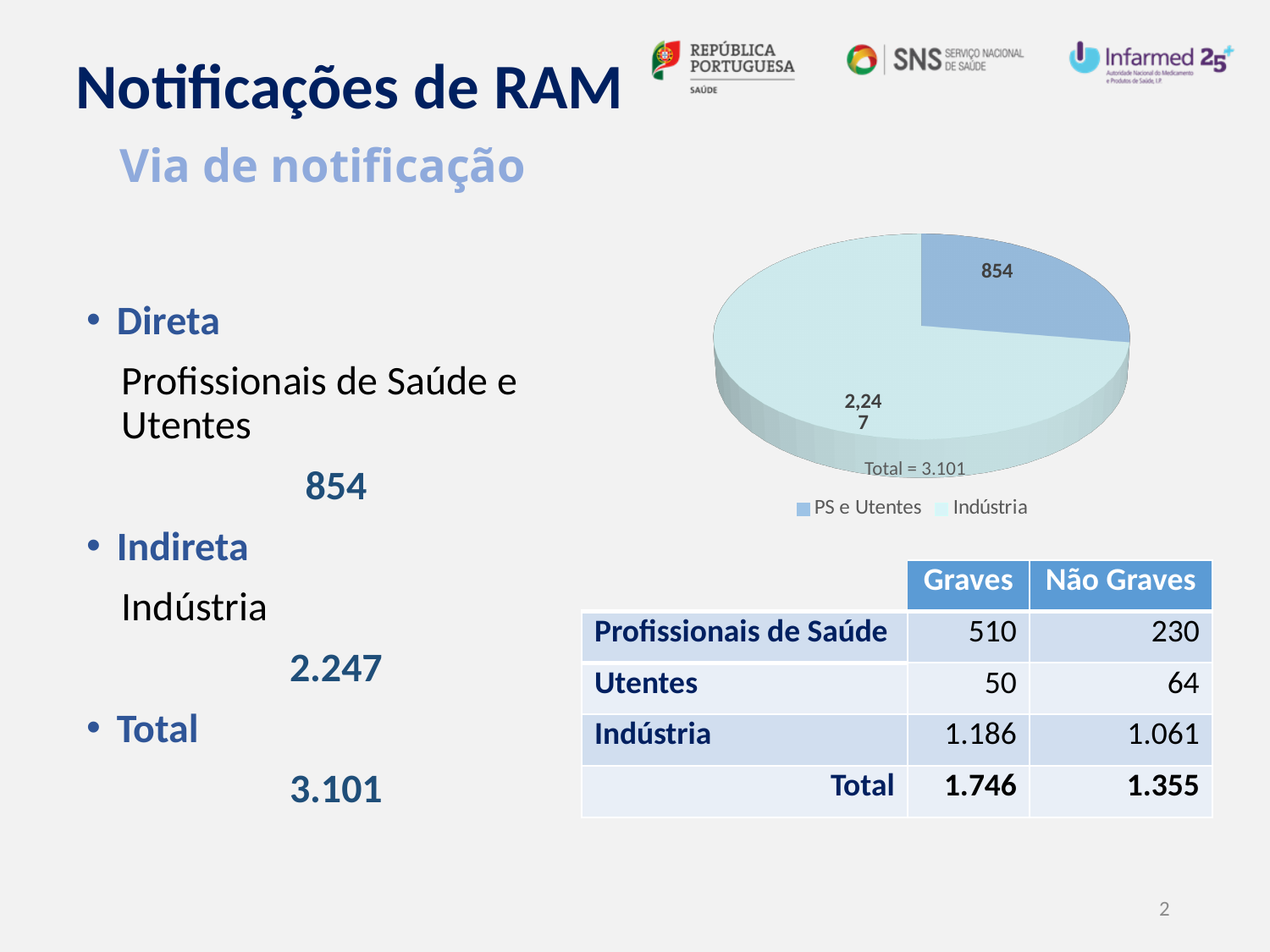
What total is printed on the pie chart? Total = 3.101 What is the difference between the Indústria and PS e Utentes values in the pie chart? 1,393 What is the value of the PS e Utentes slice in the pie chart? 854 Which slice of the pie chart is drawn in the darker blue colour? PS e Utentes What is the value of the Indústria slice in the pie chart? 2,247 Which slice of the pie chart is the smallest? PS e Utentes Which slice of the pie chart is the largest? Indústria How many slices does the pie chart have? 2 How many entries does the pie chart's legend list? 2 What are the two legend entries of the pie chart? PS e Utentes, Indústria What kind of chart is shown on the slide? pie chart In the pie chart, which is larger: PS e Utentes or Indústria? Indústria